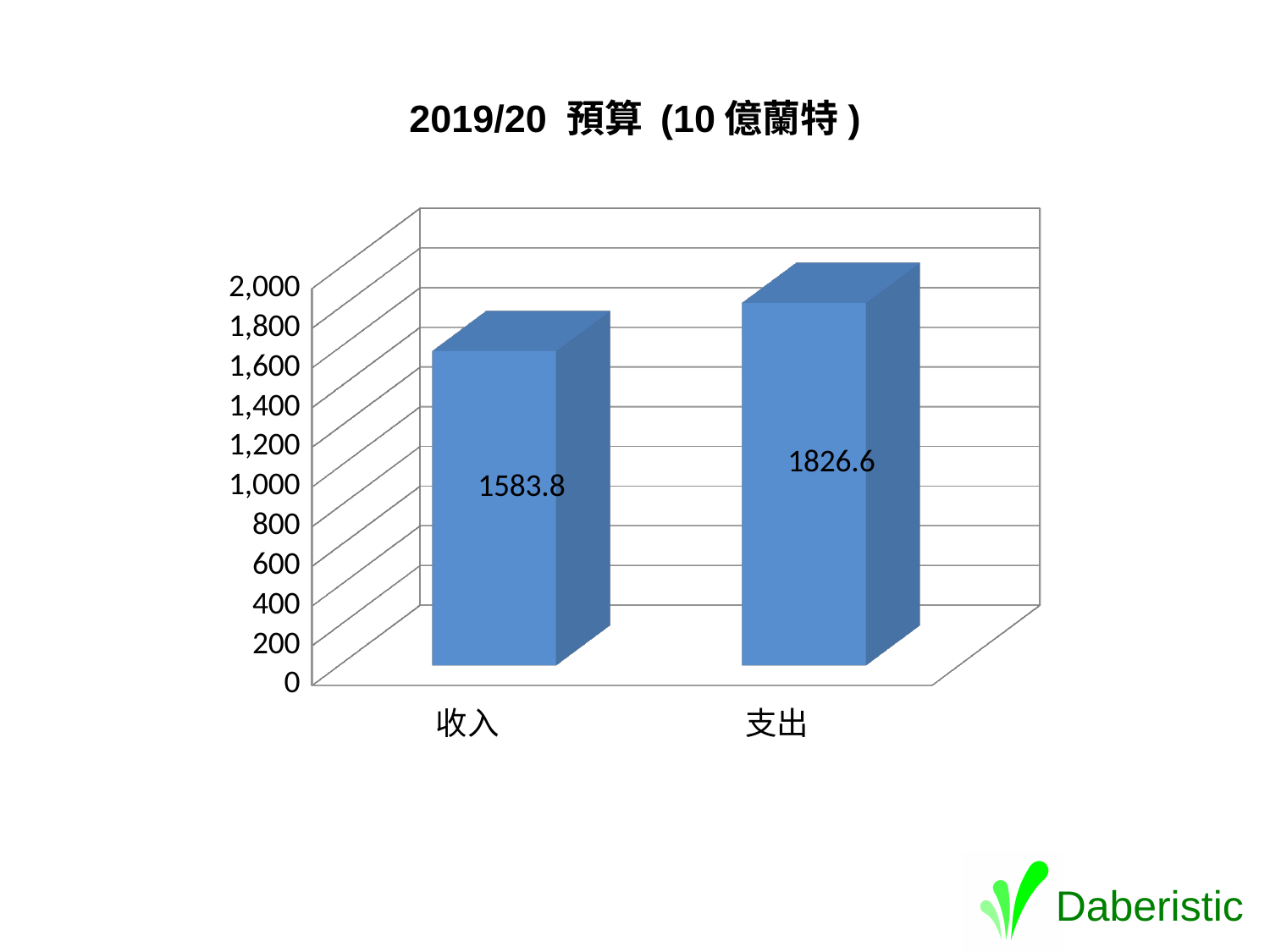
Is the value for 支出 greater or less than 2,000? less How many categories are shown on the x axis? 2 Which category has the highest value? 支出 Which category has the lowest value? 收入 What kind of chart is shown on the slide? bar chart What is the title of the chart? 2019/20 預算 (10 億蘭特) What is the value for 支出? 1826.6 Which is larger, the value for 收入 or the value for 支出? 支出 What is the value for 收入? 1583.8 Do the values rise or fall from 收入 to 支出? rise Is the value for 收入 greater or less than 1,400? greater What is the difference between the values for 支出 and 收入? 242.8